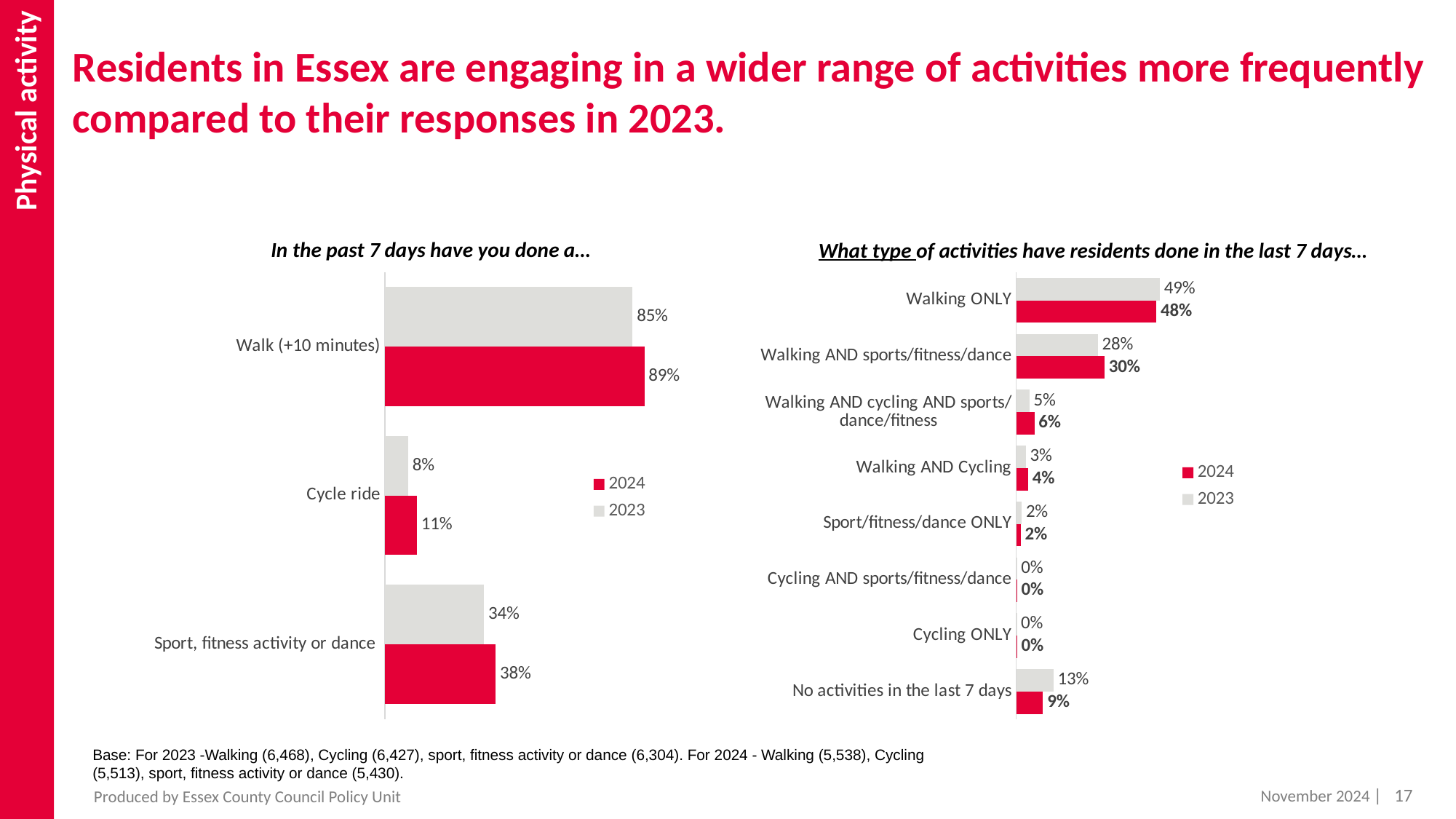
In the right chart 'What type of activities have residents done in the last 7 days...', is the 2024 value for Walking AND sports/fitness/dance larger or smaller than the 2023 value? larger In the left chart 'In the past 7 days have you done a...', which category has the lowest 2024 value? Cycle ride What type of chart is the left chart 'In the past 7 days have you done a...'? Bar chart In the right chart 'What type of activities have residents done in the last 7 days...', what is the 2024 value for No activities in the last 7 days? 9% In the left chart 'In the past 7 days have you done a...', what is the difference between the 2024 and 2023 values for Sport, fitness activity or dance? 4 percentage points In the left chart 'In the past 7 days have you done a...', how many categories are shown? 3 In the left chart 'In the past 7 days have you done a...', what is the 2023 value for Cycle ride? 8% In the right chart 'What type of activities have residents done in the last 7 days...', what is the 2023 value for Walking ONLY? 49% In the right chart 'What type of activities have residents done in the last 7 days...', which category has the highest 2024 value? Walking ONLY In the right chart 'What type of activities have residents done in the last 7 days...', how many categories are shown? 8 How many series does the legend of the right chart list? 2 In the left chart 'In the past 7 days have you done a...', what is the 2024 value for Walk (+10 minutes)? 89%